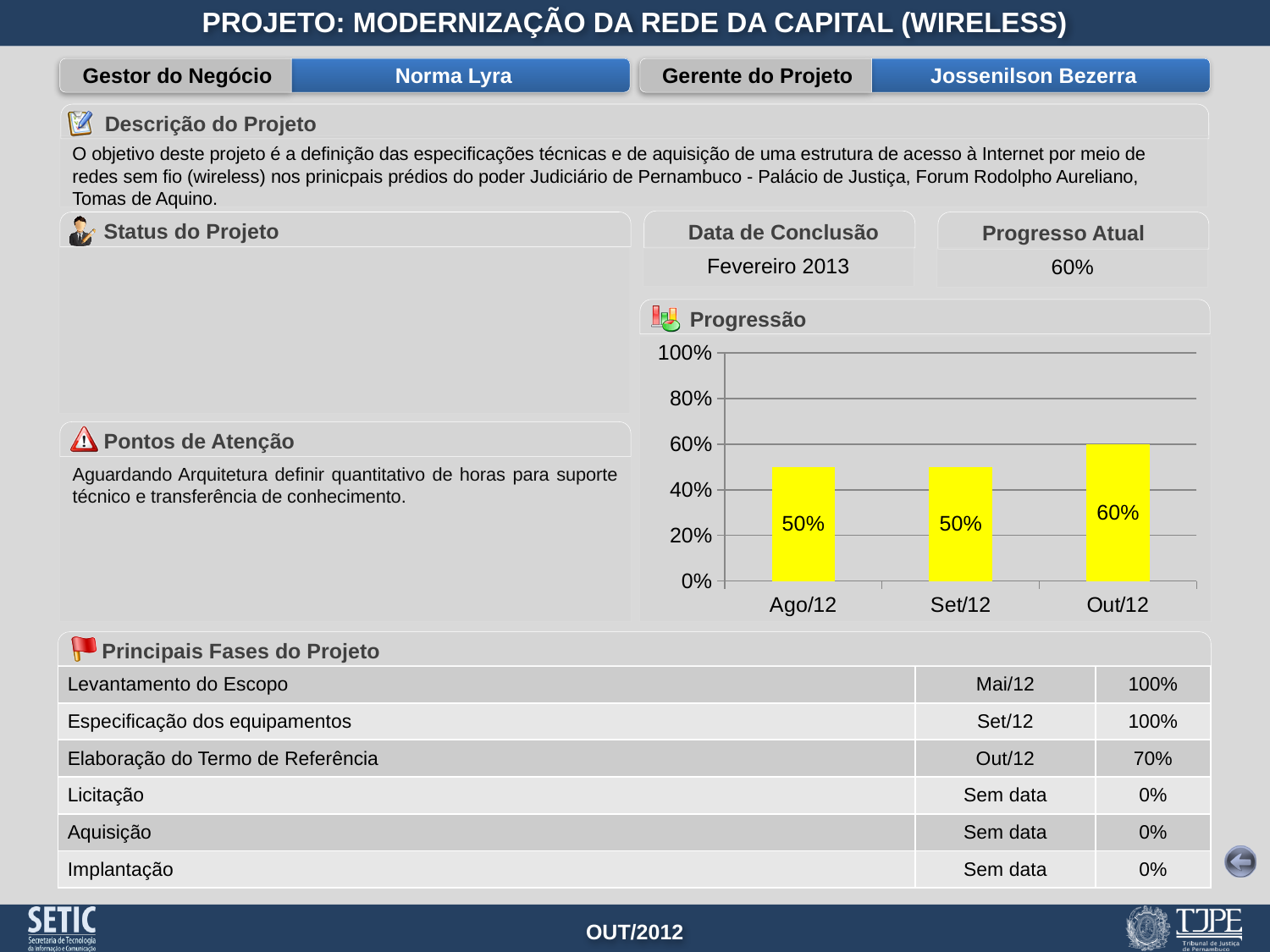
Is the value for Out/12 in the Progressão chart greater or less than 80%? less Is the value for Ago/12 in the Progressão chart greater or less than 40%? greater Which month has the highest value in the Progressão chart? Out/12 What is the value for Out/12 in the Progressão chart? 60% Do the values in the Progressão chart rise or fall from Set/12 to Out/12? rise What is the value for Ago/12 in the Progressão chart? 50% What is the difference between the values for Out/12 and Set/12 in the Progressão chart? 10% What is the value for Set/12 in the Progressão chart? 50% How many months are plotted in the Progressão chart? 3 What kind of chart is the Progressão chart? bar chart What colour are the bars in the Progressão chart? yellow Which is larger in the Progressão chart, the value for Ago/12 or the value for Out/12? Out/12